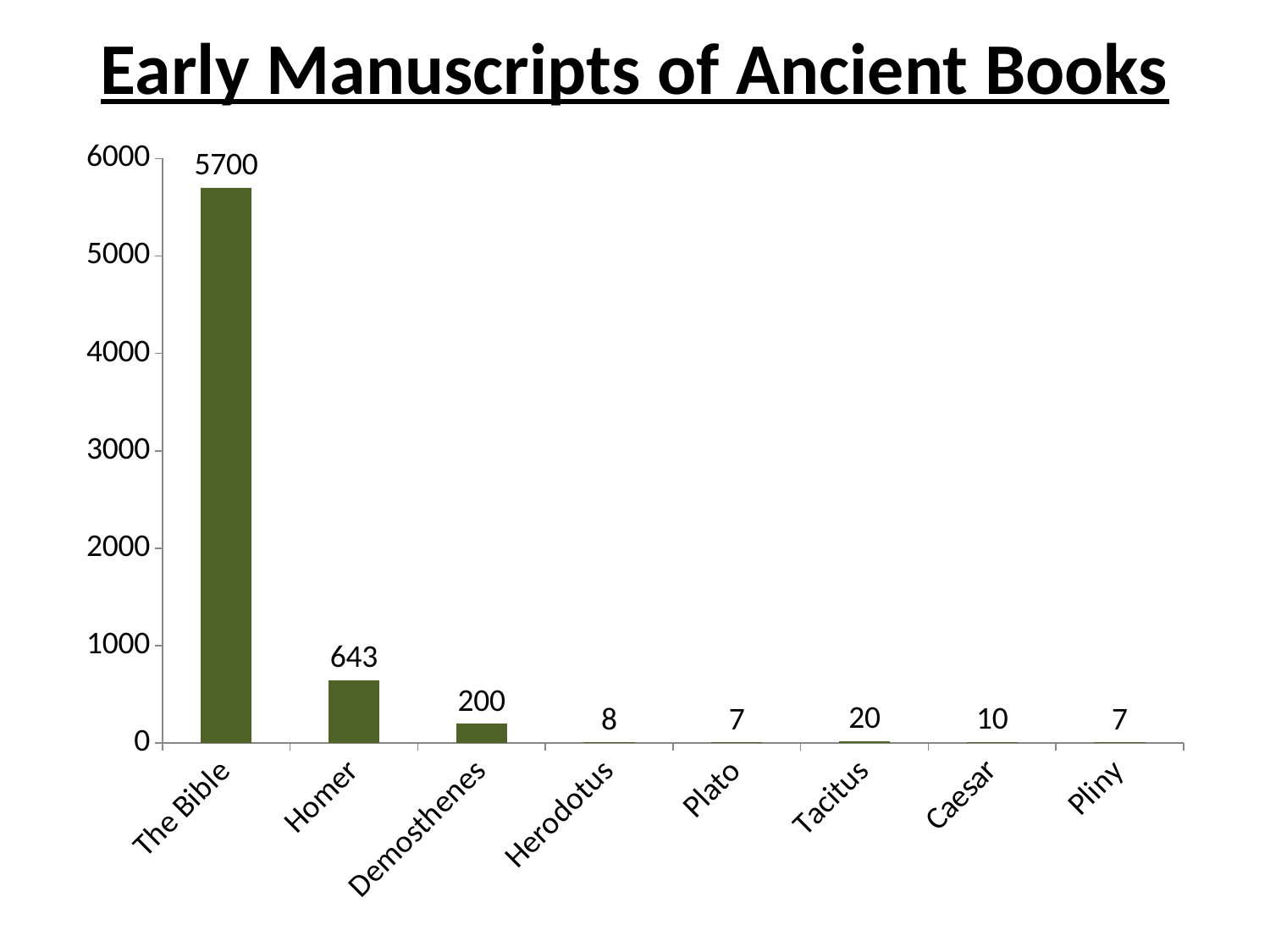
Which is larger, the value for Tacitus or the value for Caesar? Tacitus What is the difference between the values for Homer and Demosthenes? 443 What is the value for Tacitus? 20 Which category has the highest value? The Bible What is the value for Demosthenes? 200 What kind of chart is shown on the slide? bar chart Is the value for Homer greater or less than 1000? less What is the difference between the values for The Bible and Homer? 5057 What is the title of the chart? Early Manuscripts of Ancient Books What is the value for The Bible? 5700 How many categories are shown on the x axis? 8 What is the value for Homer? 643